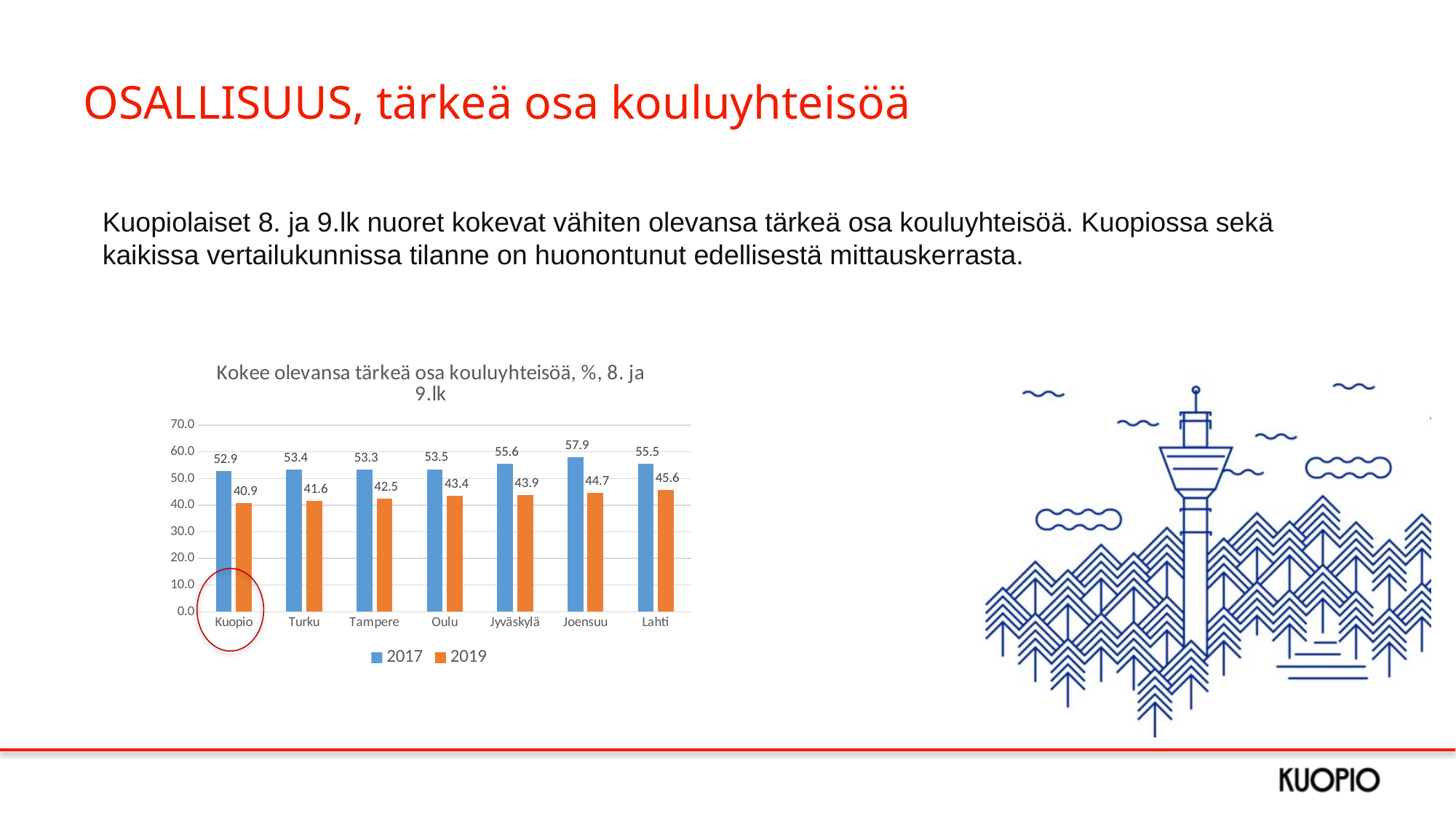
What kind of chart is shown? bar chart How many cities are shown on the x axis? 7 Which is larger, the 2019 value for Oulu or the 2019 value for Tampere? Oulu Which years are listed in the legend? 2017 and 2019 Which city has the lowest 2019 value? Kuopio Which city has the highest 2017 value? Joensuu How many series does the legend list? 2 What is the 2019 value for Lahti? 45.6 What is the 2019 value for Kuopio? 40.9 What is the difference between the 2017 and 2019 values for Kuopio? 12.0 What is the 2017 value for Joensuu? 57.9 Is the 2019 value for Jyväskylä greater or less than 50.0? less